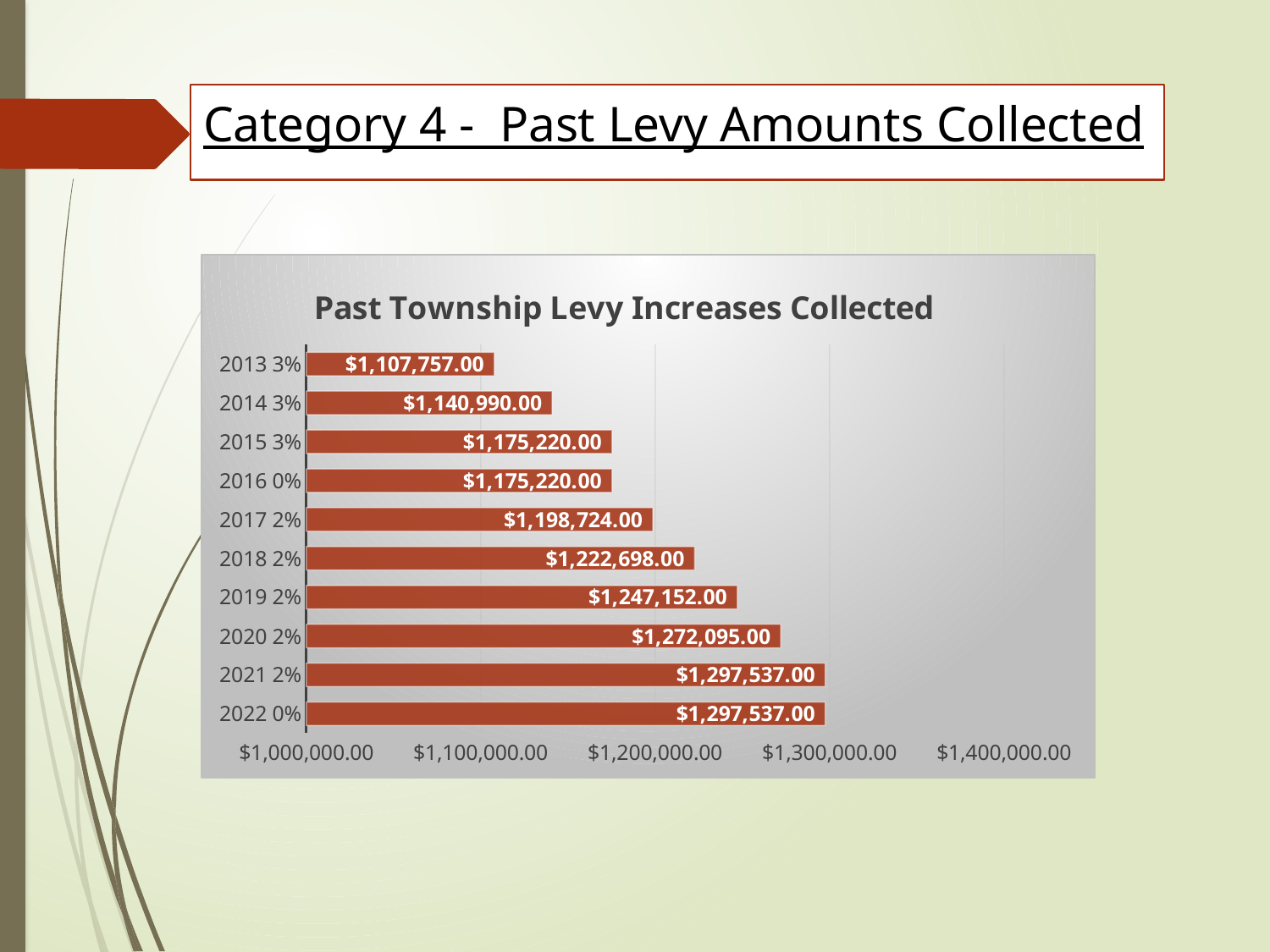
What is the title of the chart? Past Township Levy Increases Collected What kind of chart is shown on the slide? bar chart How many bars are shown in the chart? 10 What is the difference between the values for 2014 3% and 2013 3%? $33,233.00 What is the highest value shown in the chart? $1,297,537.00 What is the value for 2017 2%? $1,198,724.00 Which is larger, the value for 2018 2% or the value for 2015 3%? 2018 2% What is the value for 2013 3% in the Past Township Levy Increases Collected chart? $1,107,757.00 What amount is shown for 2019 2%? $1,247,152.00 What is the difference between the values for 2022 0% and 2013 3%? $189,780.00 Which category has the lowest value? 2013 3% Is the value for 2019 2% greater or less than $1,200,000.00? greater